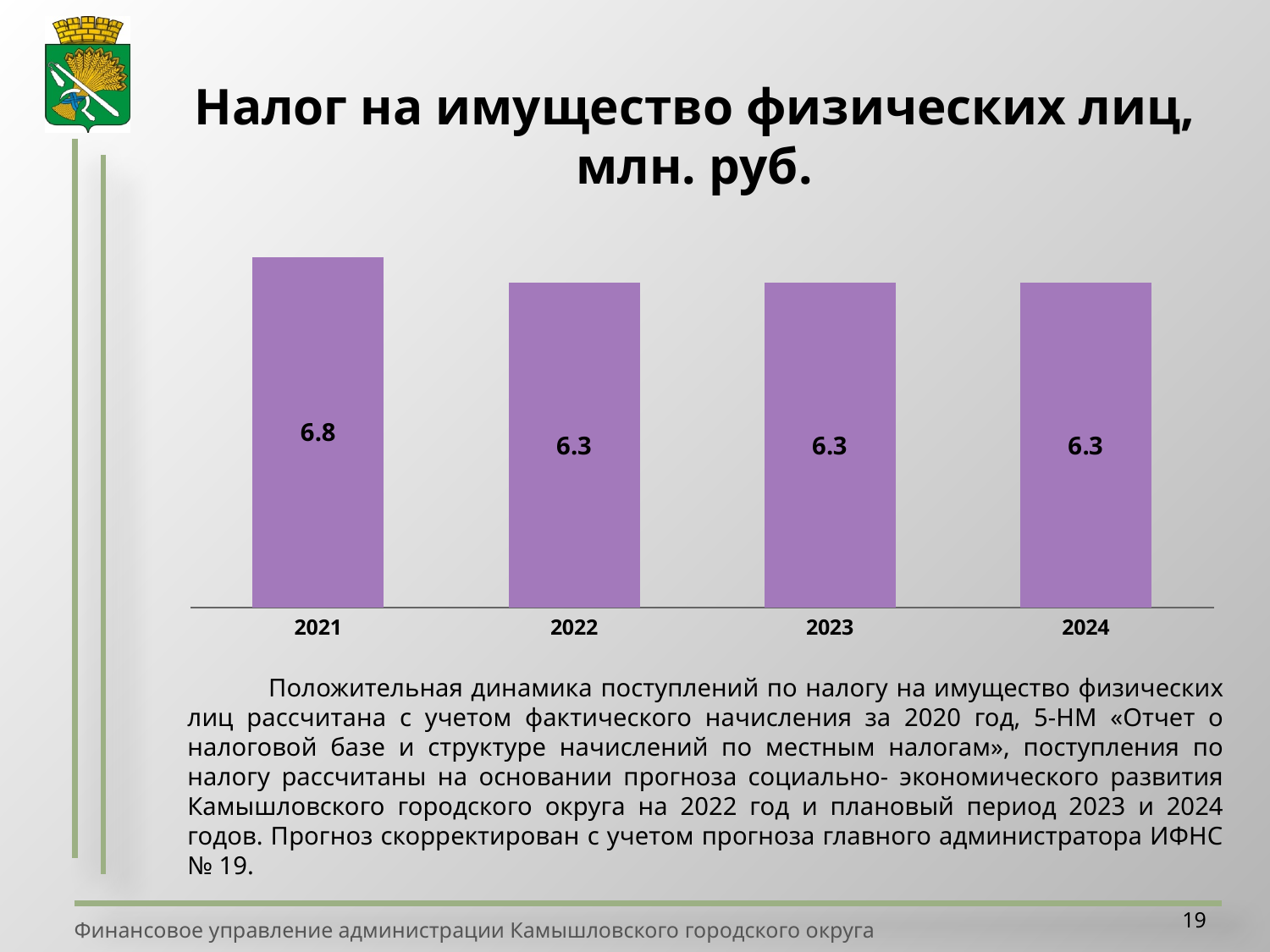
Do the values rise or fall from 2021 to 2022? fall How many years are shown on the chart? 4 What is the value for 2024? 6.3 Are the values for 2022, 2023 and 2024 the same or different? the same Which year has the highest value? 2021 What is the difference between the values for 2021 and 2022? 0.5 What kind of chart is shown on the slide? bar chart Which is larger, the value for 2021 or the value for 2023? 2021 What is the title of the chart? Налог на имущество физических лиц, млн. руб. What is the value for 2022? 6.3 What colour are the bars in the chart? purple What is the value for 2021? 6.8